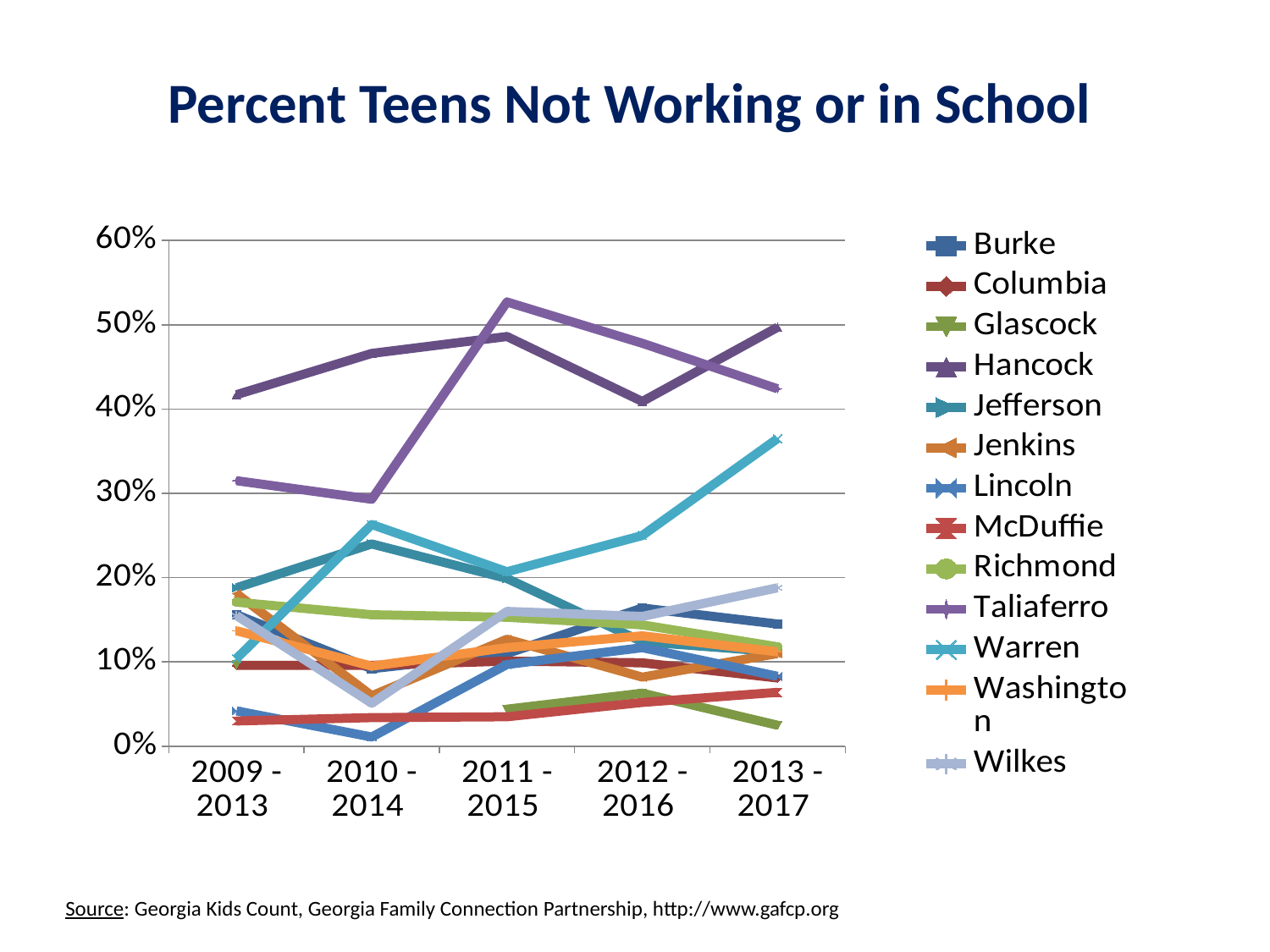
Which county has the lowest value in 2010 - 2014? Lincoln Is the value for Warren in 2013 - 2017 greater or less than 30%? greater How many series does the legend list? 13 Is the value for Hancock in 2009 - 2013 greater or less than 40%? greater Which county has the highest value in 2011 - 2015? Taliaferro In 2012 - 2016, which is larger, the value for Taliaferro or the value for Hancock? Taliaferro Does the value for Jefferson rise or fall from 2010 - 2014 to 2013 - 2017? fall What is the title of the chart? Percent Teens Not Working or in School Which county has the highest value in 2013 - 2017? Hancock What kind of chart is shown on the slide? line chart How many time periods are shown on the x axis? 5